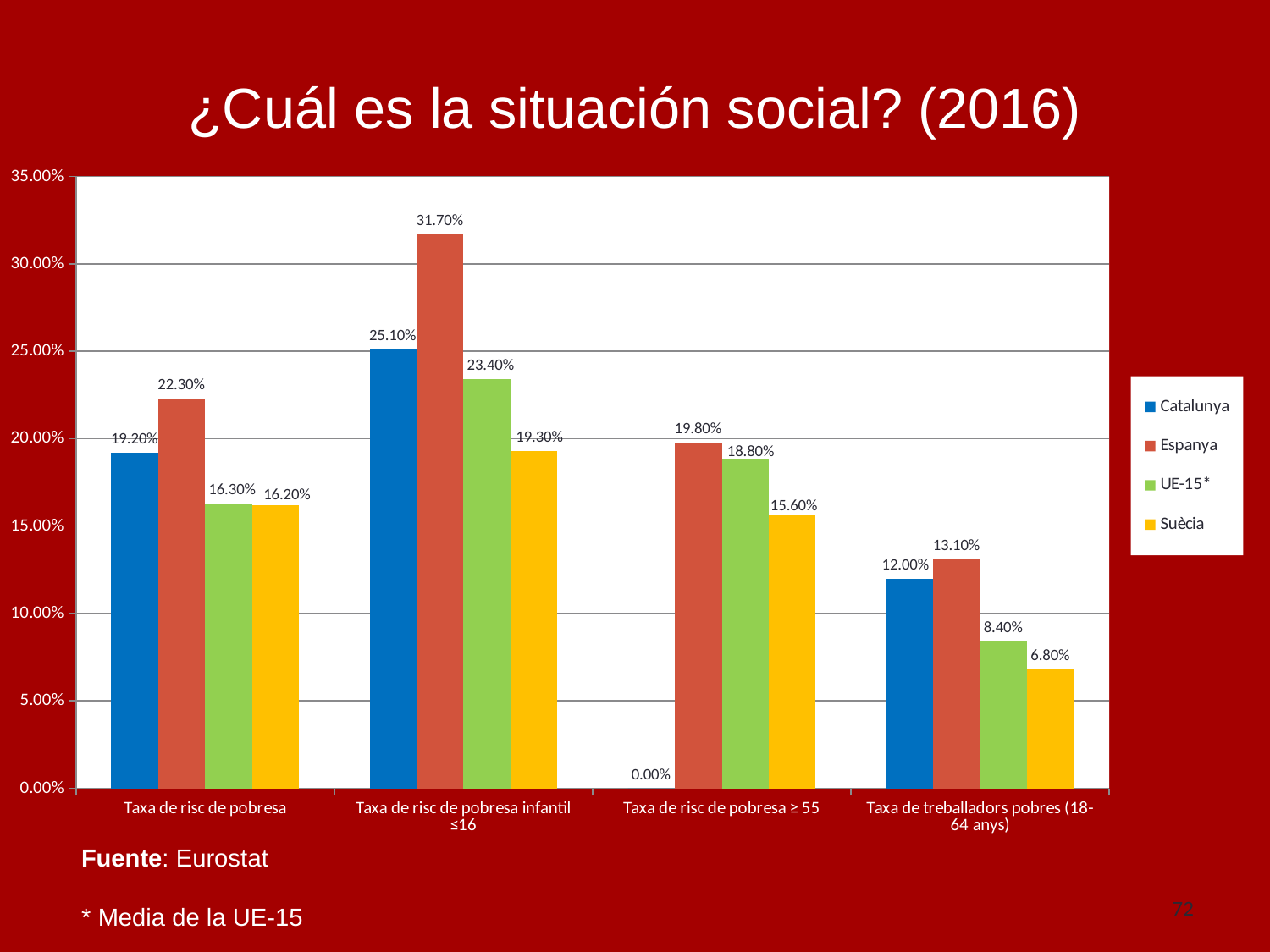
How many categories are shown on the x axis? 4 Which series has the lowest value in the 'Taxa de treballadors pobres (18-64 anys)' category? Suècia What is the value for Catalunya in the 'Taxa de risc de pobresa ≥ 55' category? 0.00% Which is larger in the 'Taxa de risc de pobresa ≥ 55' category: the value for Espanya or the value for Suècia? Espanya What is the value for UE-15* in the 'Taxa de risc de pobresa ≥ 55' category? 18.80% What is the value for Catalunya in the 'Taxa de risc de pobresa' category? 19.20% What is the value for Suècia in the 'Taxa de treballadors pobres (18-64 anys)' category? 6.80% What is the difference between the Espanya and Catalunya values in the 'Taxa de risc de pobresa infantil ≤16' category? 6.60% What kind of chart is shown on the slide? Bar chart How many series does the legend list? 4 What is the value for Espanya in the 'Taxa de risc de pobresa infantil ≤16' category? 31.70% Which series has the highest value in the 'Taxa de risc de pobresa infantil ≤16' category? Espanya